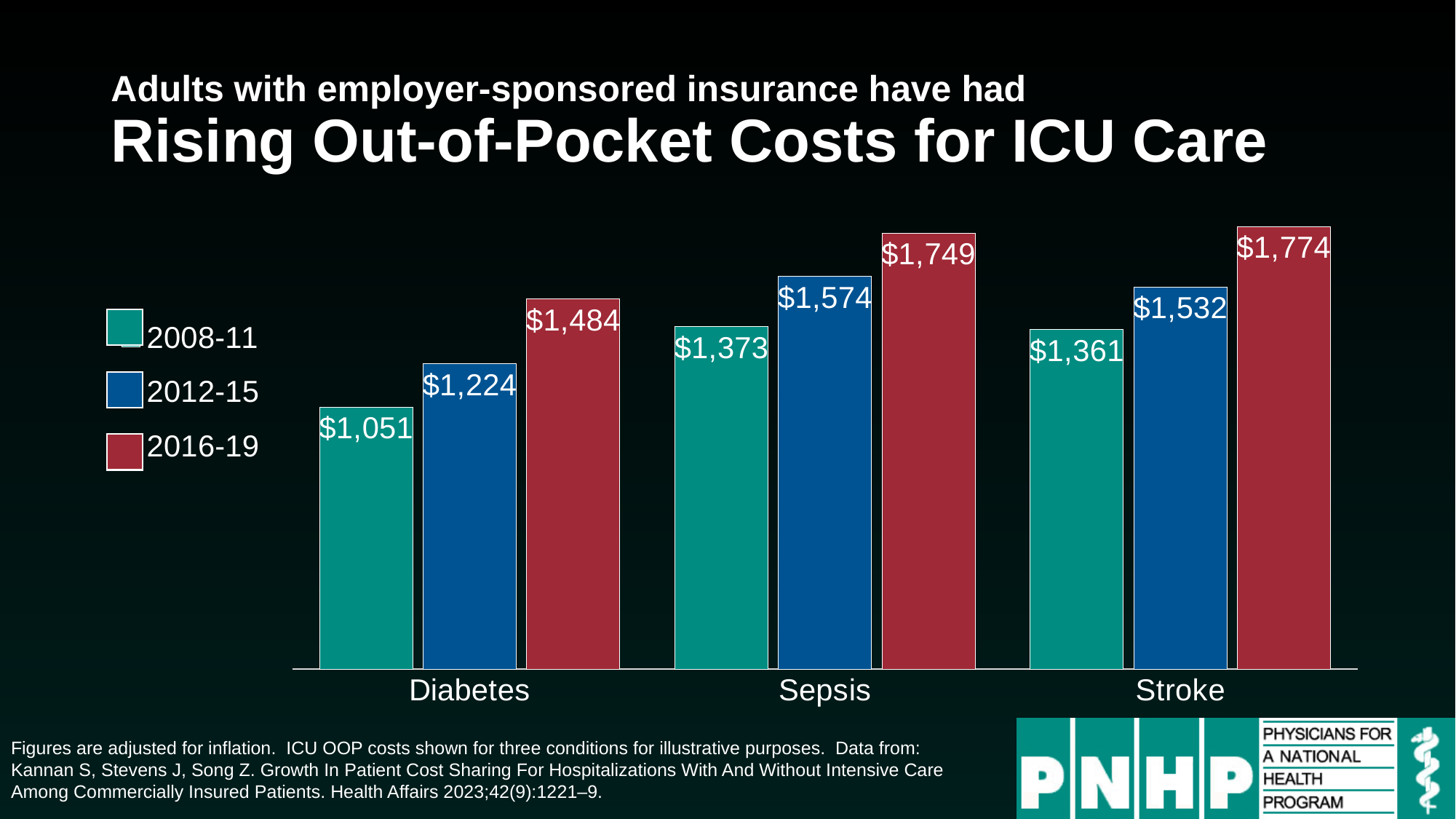
How many conditions are shown on the x axis? 3 What is the out-of-pocket cost for Diabetes in 2008-11? $1,051 What kind of chart is shown on the slide? Bar chart What is the difference between the Sepsis and Stroke out-of-pocket costs in 2012-15? $42 Which condition has the highest out-of-pocket cost in 2016-19? Stroke Which condition has the lowest out-of-pocket cost in 2008-11? Diabetes Which is larger, the 2008-11 cost for Sepsis or the 2008-11 cost for Stroke? Sepsis What is the out-of-pocket cost for Sepsis in 2016-19? $1,749 What is the difference between the 2016-19 and 2008-11 out-of-pocket costs for Diabetes? $433 Which legend entry is shown in red? 2016-19 What is the out-of-pocket cost for Stroke in 2012-15? $1,532 How many series does the legend list? 3